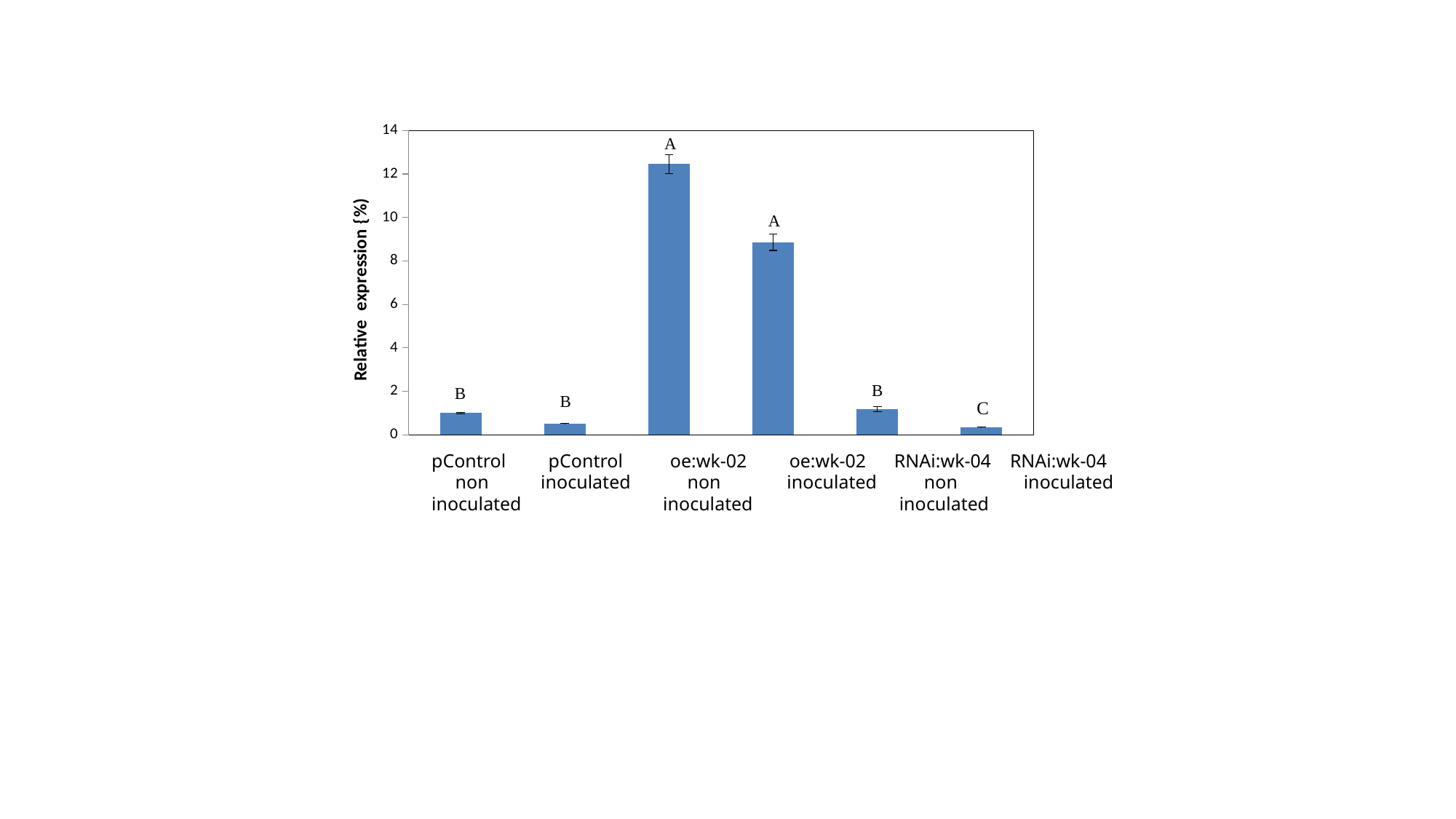
Is the value for RNAi:wk-04 non inoculated greater or less than 2? less Is the value for pControl non inoculated greater or less than 2? less Which is larger, the value for oe:wk-02 non inoculated or oe:wk-02 inoculated? oe:wk-02 non inoculated How many categories are plotted on the x axis? 6 What kind of chart is shown on the slide? bar chart Which is larger, the value for pControl non inoculated or RNAi:wk-04 inoculated? pControl non inoculated Is the value for oe:wk-02 inoculated greater or less than 8? greater What letter is printed above the oe:wk-02 non inoculated bar? A Which category has the highest relative expression? oe:wk-02 non inoculated What is the title of the y axis? Relative expression {%}